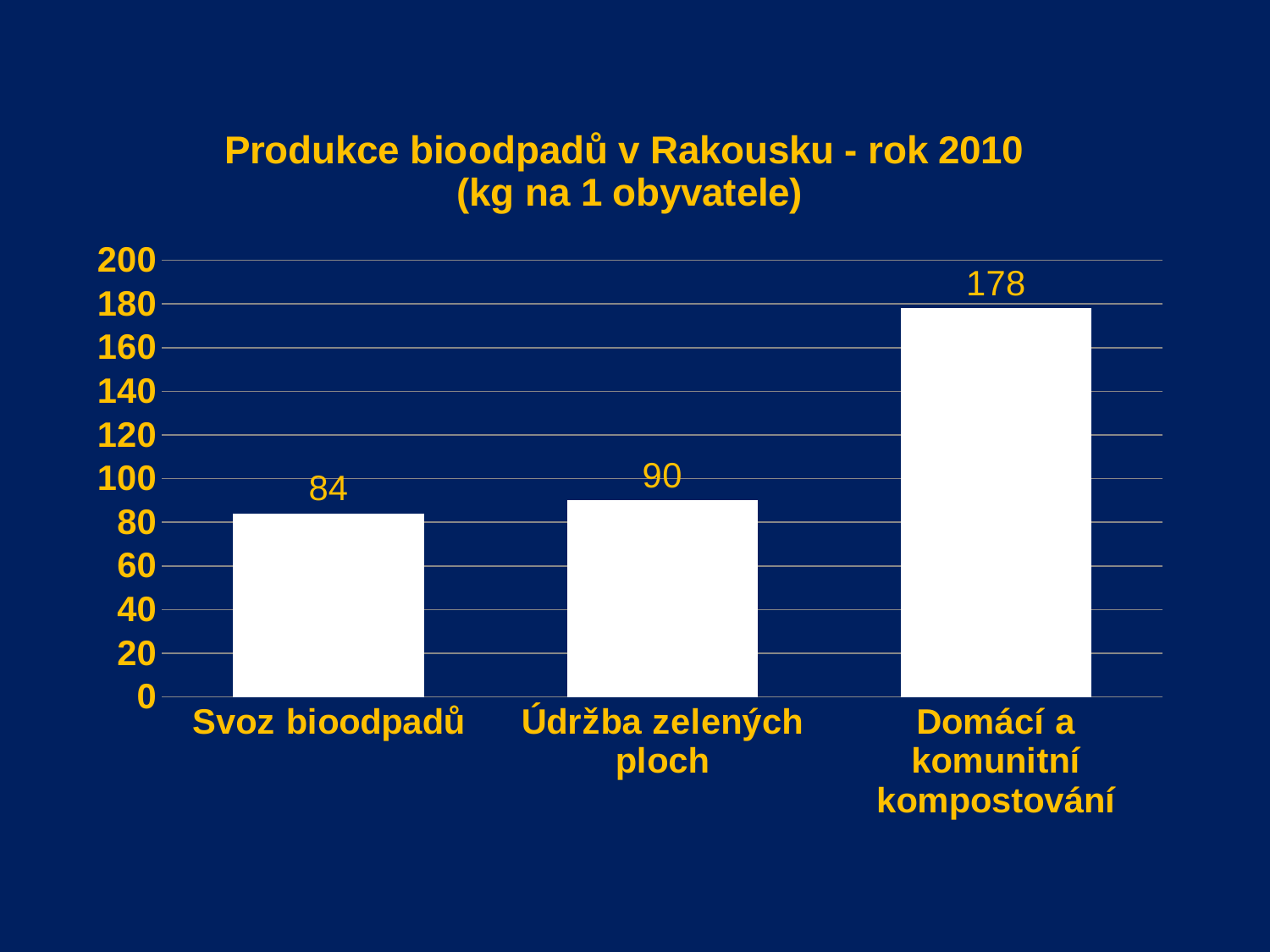
What is the value for Údržba zelených ploch? 90 Which is larger, the value for Svoz bioodpadů or the value for Domácí a komunitní kompostování? Domácí a komunitní kompostování What is the value for Domácí a komunitní kompostování? 178 What is the title of the chart? Produkce bioodpadů v Rakousku - rok 2010 (kg na 1 obyvatele) What kind of chart is shown on the slide? bar chart Which category has the highest value? Domácí a komunitní kompostování What is the difference between the values for Domácí a komunitní kompostování and Údržba zelených ploch? 88 Which category has the lowest value? Svoz bioodpadů What is the value for Svoz bioodpadů? 84 What is the difference between the values for Údržba zelených ploch and Svoz bioodpadů? 6 Is the value for Domácí a komunitní kompostování greater or less than 160? greater How many categories are shown in the chart? 3